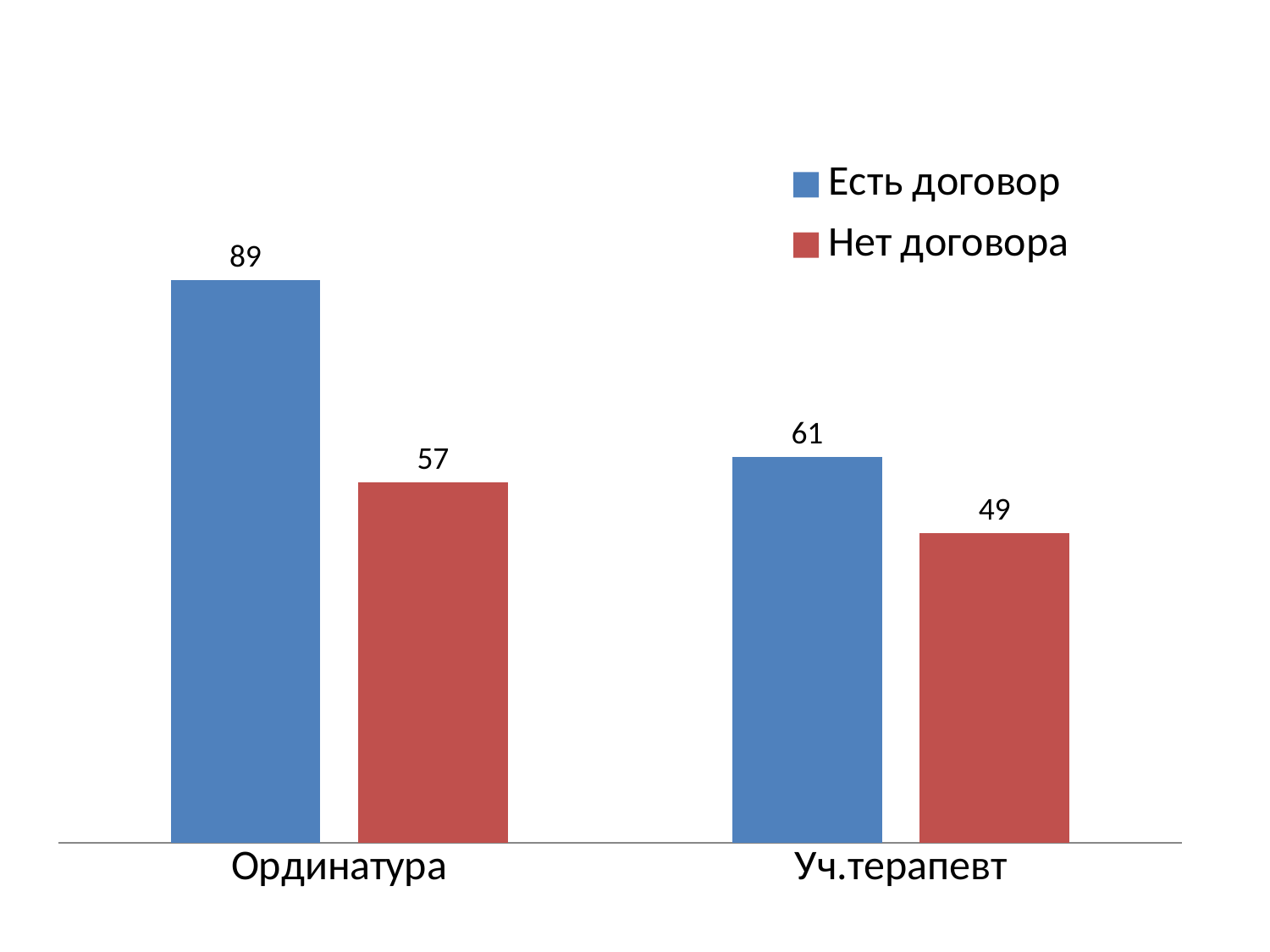
How many categories are shown on the x axis? 2 What is the value for "Нет договора" in the "Ординатура" category? 57 Which bar has the lowest value on the chart? Нет договора for Уч.терапевт What is the value for "Есть договор" in the "Уч.терапевт" category? 61 What is the value for "Нет договора" in the "Уч.терапевт" category? 49 How many series does the legend list? 2 What is the difference between "Есть договор" and "Нет договора" in the "Ординатура" category? 32 What is the difference between the "Есть договор" values for "Ординатура" and "Уч.терапевт"? 28 Which is larger: "Нет договора" for "Ординатура" or "Есть договор" for "Уч.терапевт"? Есть договор for Уч.терапевт What kind of chart is shown on the slide? Bar chart What is the value for "Есть договор" in the "Ординатура" category? 89 Which category has the highest value for "Есть договор"? Ординатура